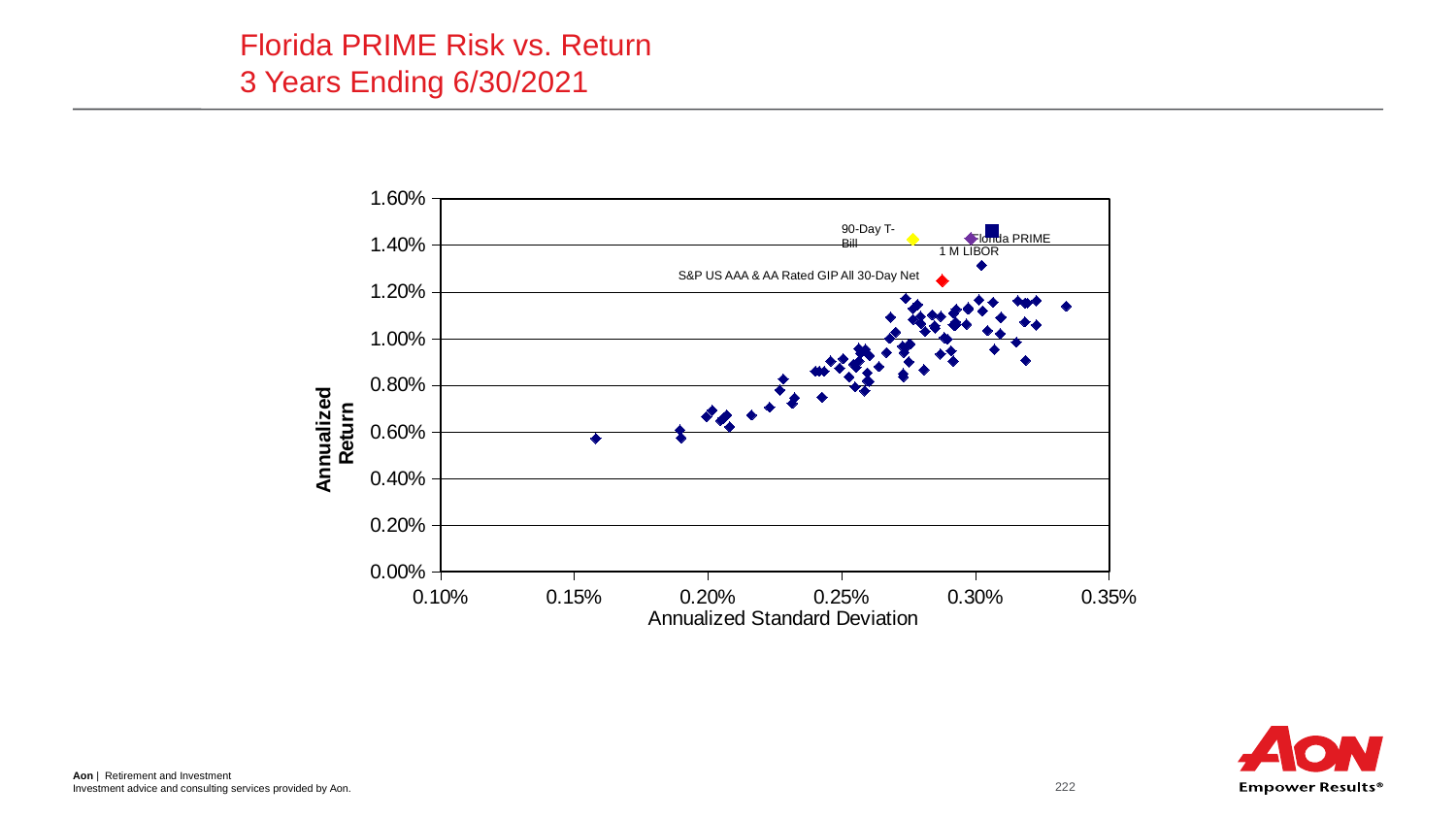
What is the label of the horizontal axis? Annualized Standard Deviation Is the Annualized Standard Deviation for the 90-Day T-Bill greater or less than 0.30%? less What is the title of the chart? Florida PRIME Risk vs. Return 3 Years Ending 6/30/2021 Is the Annualized Standard Deviation for Florida PRIME greater or less than 0.25%? greater Is the Annualized Return for Florida PRIME greater or less than 1.40%? greater What is the highest value shown on the Annualized Return axis? 1.60% Which has the higher Annualized Return, Florida PRIME or S&P US AAA & AA Rated GIP All 30-Day Net? Florida PRIME How many named (labeled) points are marked on the chart? 4 What kind of chart is shown on the slide? Scatter chart As Annualized Standard Deviation increases along the x axis, do the plotted Annualized Returns generally rise or fall? rise